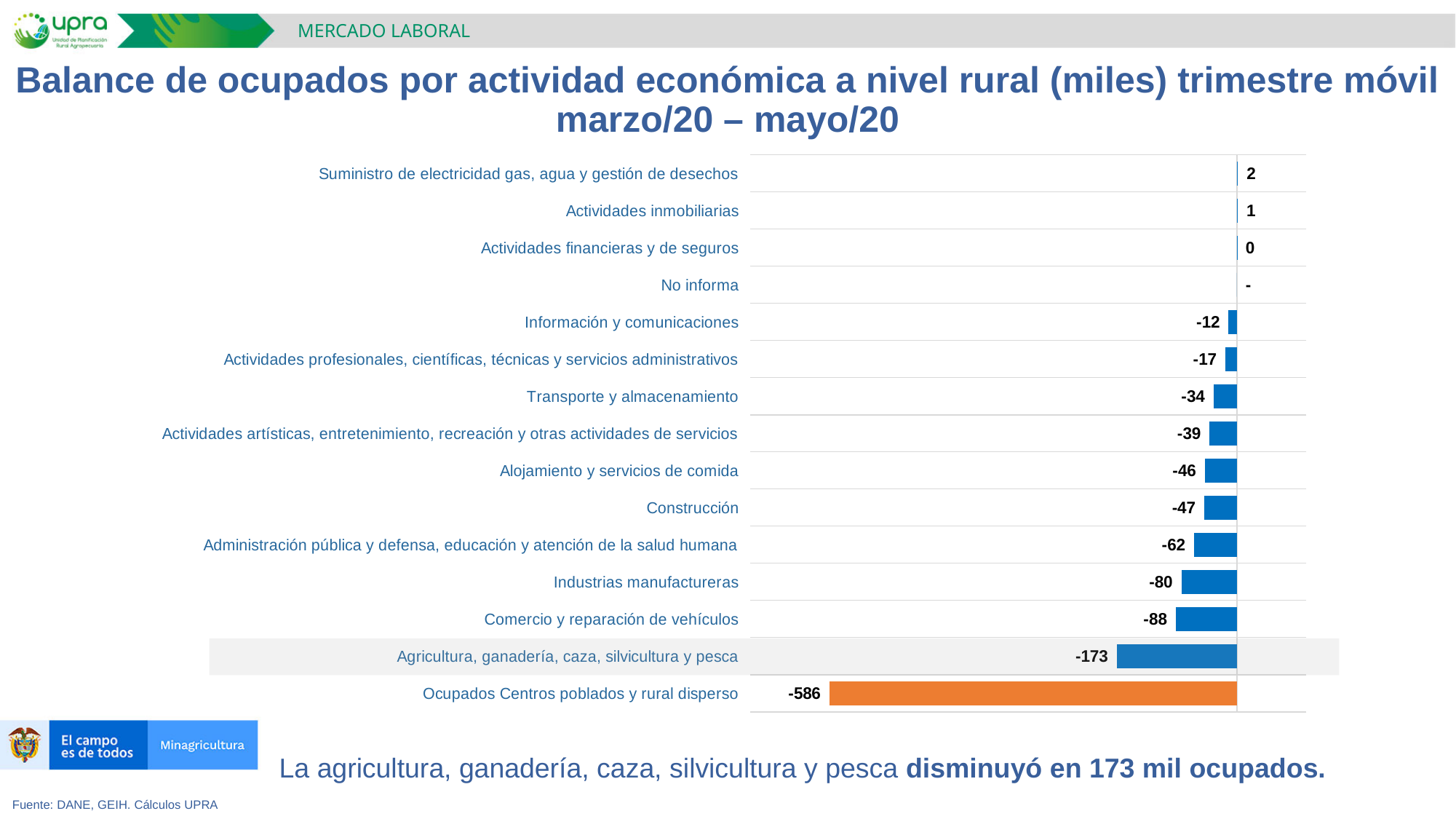
What is the value for Industrias manufactureras? -80 What is the value for Ocupados Centros poblados y rural disperso? -586 What is the value for Suministro de electricidad gas, agua y gestión de desechos? 2 Which category's bar is coloured orange instead of blue? Ocupados Centros poblados y rural disperso Which has a larger decline, Construcción or Transporte y almacenamiento? Construcción What is the value for Comercio y reparación de vehículos? -88 How many categories are shown in the chart? 15 Which category has the highest value? Suministro de electricidad gas, agua y gestión de desechos What is the difference between the values for Comercio y reparación de vehículos and Industrias manufactureras? 8 What type of chart is shown on the slide? Bar chart Which category has the lowest (most negative) value? Ocupados Centros poblados y rural disperso What is the value for Agricultura, ganadería, caza, silvicultura y pesca? -173